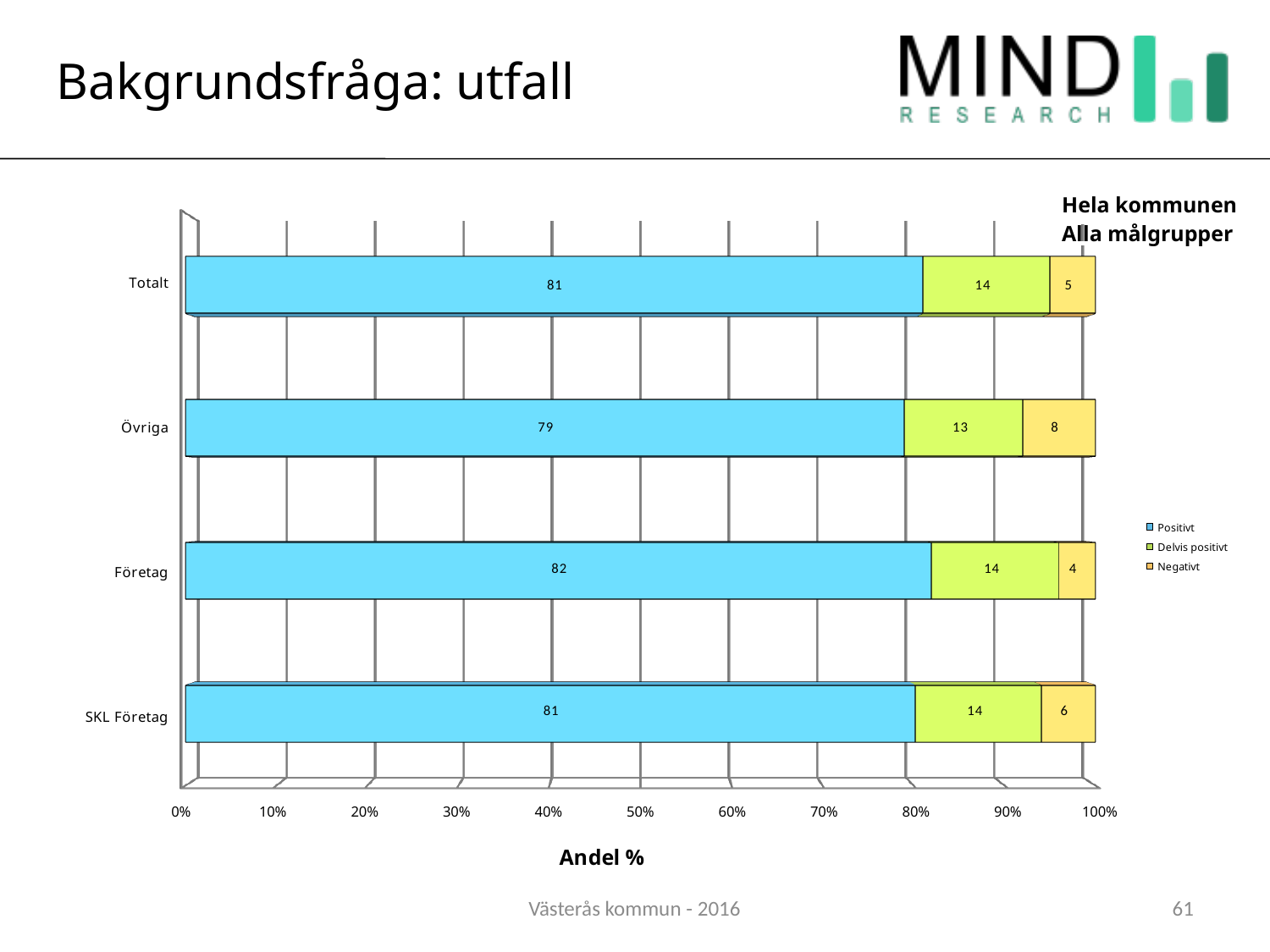
What is the difference between the Positivt values for Företag and Övriga? 3 Which is larger, the Negativt value for Övriga or for Totalt? Övriga What kind of chart is shown on the slide? Stacked bar chart How many series does the legend list? 3 What is the Negativt value for Övriga? 8 What is the Positivt value for Företag? 82 What is the label of the x axis? Andel % Which category has the lowest Negativt value? Företag Which category has the highest Positivt value? Företag What is the Delvis positivt value for SKL Företag? 14 What is the total of the stacked bar for Totalt? 100 How many categories are shown on the y axis? 4